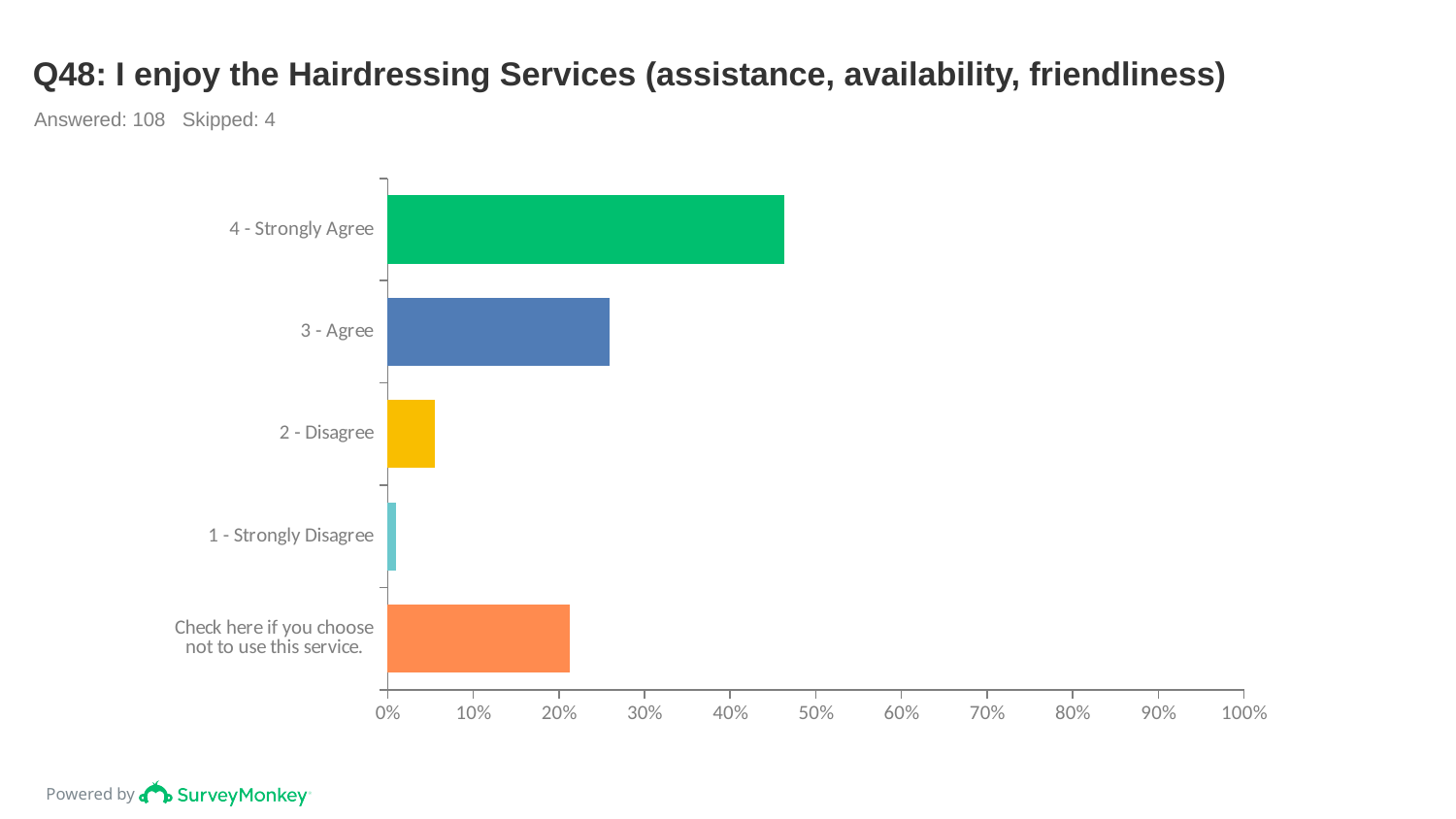
Which is larger, the value for 3 - Agree or the value for 'Check here if you choose not to use this service.'? 3 - Agree How many respondents answered this question according to the slide? 108 Which category has the highest value? 4 - Strongly Agree Is the value for 2 - Disagree greater or less than 10%? less What kind of chart is shown on the slide? bar chart Which is larger, the value for 2 - Disagree or the value for 1 - Strongly Disagree? 2 - Disagree Which category has the lowest value? 1 - Strongly Disagree Is the value for 'Check here if you choose not to use this service.' greater or less than 20%? greater What is the title of the chart? Q48: I enjoy the Hairdressing Services (assistance, availability, friendliness) Is the value for 4 - Strongly Agree greater or less than 40%? greater How many categories are shown on the chart? 5